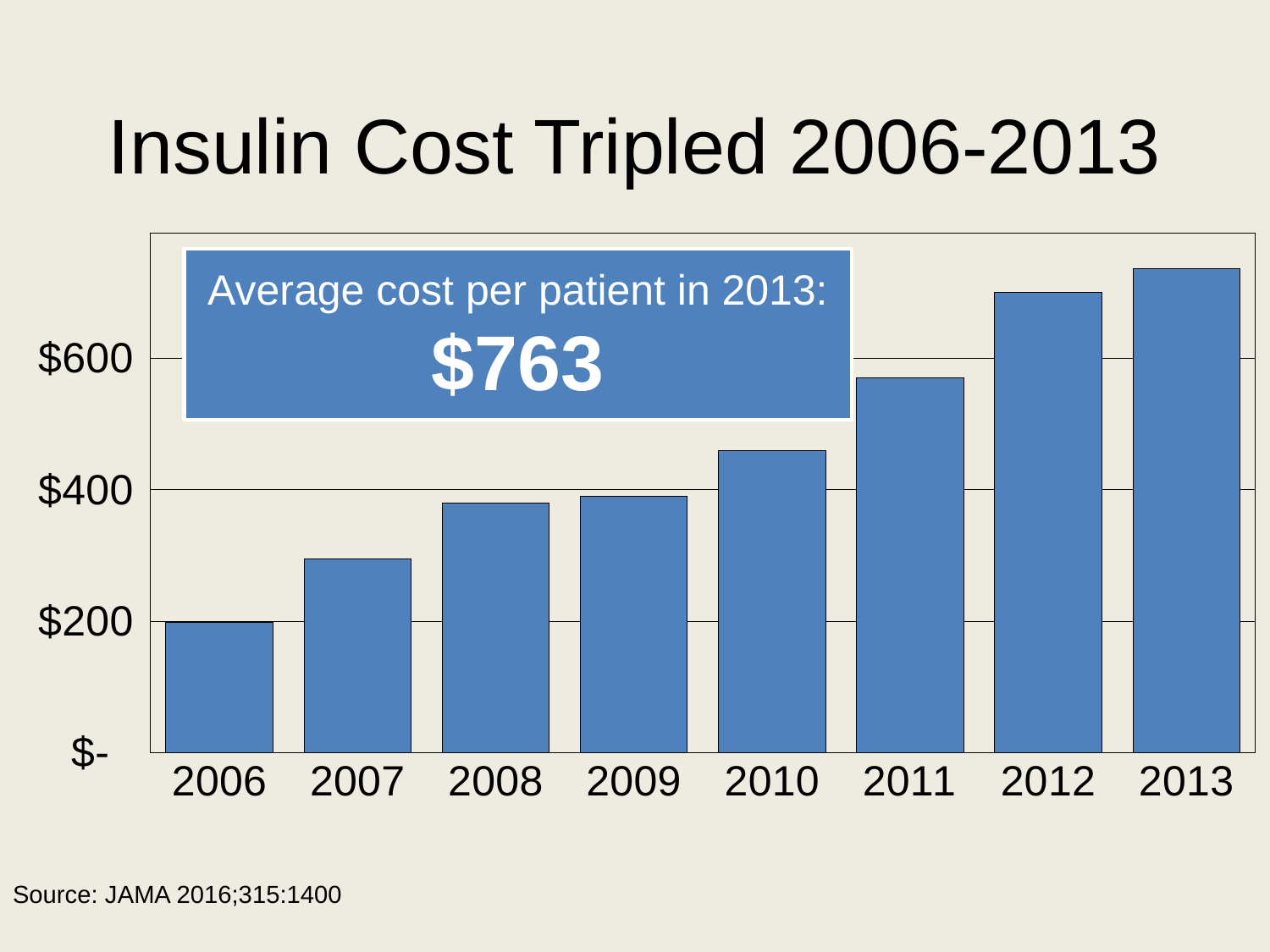
What is the average insulin cost per patient in 2013? $763 What is the title of the slide? Insulin Cost Tripled 2006-2013 Is the value for 2012 greater or less than $600? greater Which year has the highest insulin cost per patient? 2013 Is the value for 2010 greater or less than $400? greater Which year has the larger value, 2008 or 2011? 2011 Is the value for 2007 greater or less than $400? less How many years are shown on the x axis of the chart? 8 What kind of chart is shown on the slide? bar chart Do the values rise or fall from 2006 to 2013? rise Which year has the lowest insulin cost per patient? 2006